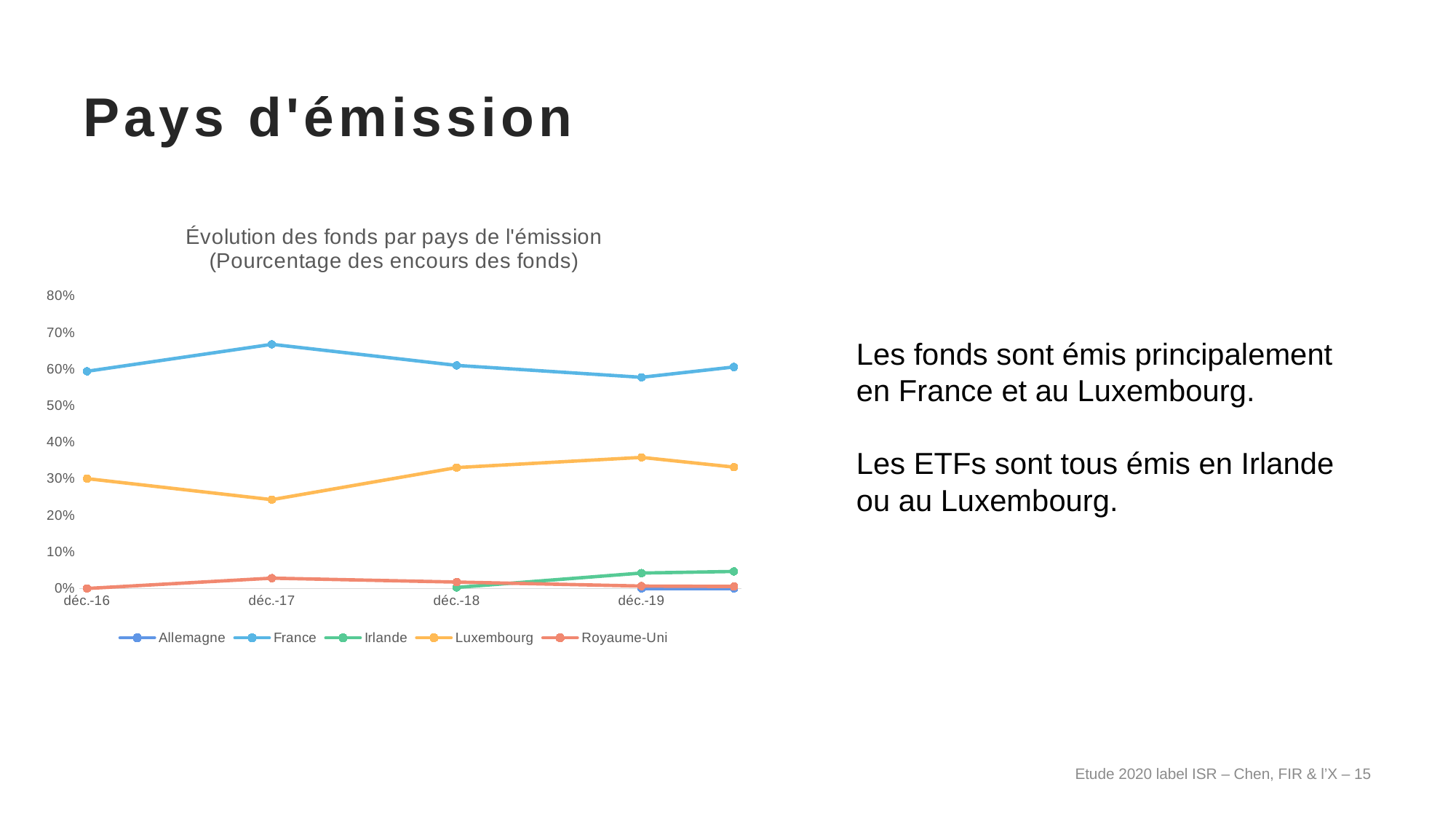
What kind of chart is shown on the slide? line chart Is the value for France at déc.-16 greater or less than 50%? greater Which is larger at déc.-16, the value for France or the value for Luxembourg? France Is the value for Luxembourg at déc.-17 greater or less than 30%? less What is the title of the chart? Évolution des fonds par pays de l'émission (Pourcentage des encours des fonds) Is the value for Luxembourg at déc.-19 greater or less than 30%? greater Does the value for Luxembourg rise or fall from déc.-17 to déc.-19? rise Which country has the highest value at déc.-17? France Which is larger at déc.-19, the value for Irlande or the value for Royaume-Uni? Irlande Which country has the second highest value at déc.-19? Luxembourg How many series does the legend list? 5